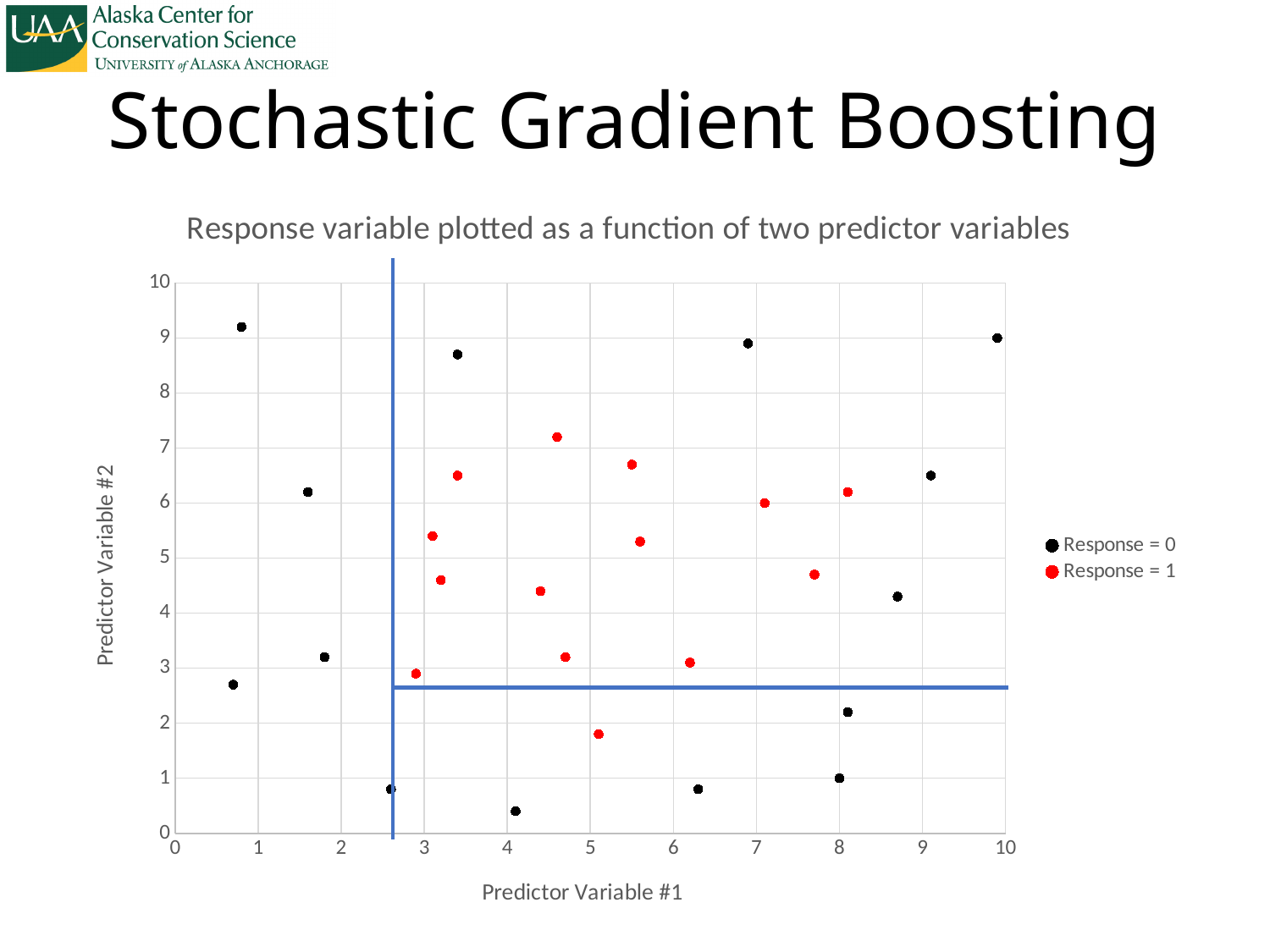
Which series contains the point with the highest Predictor Variable #2 value? Response = 0 Which series contains the point with the lowest Predictor Variable #1 value? Response = 0 Is the Predictor Variable #2 value of the highest Response = 1 point greater or less than 8? less What kind of chart is shown on the slide? Scatter chart Is the Predictor Variable #2 value of the lowest Response = 0 point greater or less than 1? less What is the title of the chart? Response variable plotted as a function of two predictor variables Is the Predictor Variable #1 value of the leftmost Response = 1 point greater or less than 2? greater Which series contains the point with the highest Predictor Variable #1 value? Response = 0 How many series does the legend list? 2 What are the two legend entries of the chart? Response = 0 and Response = 1